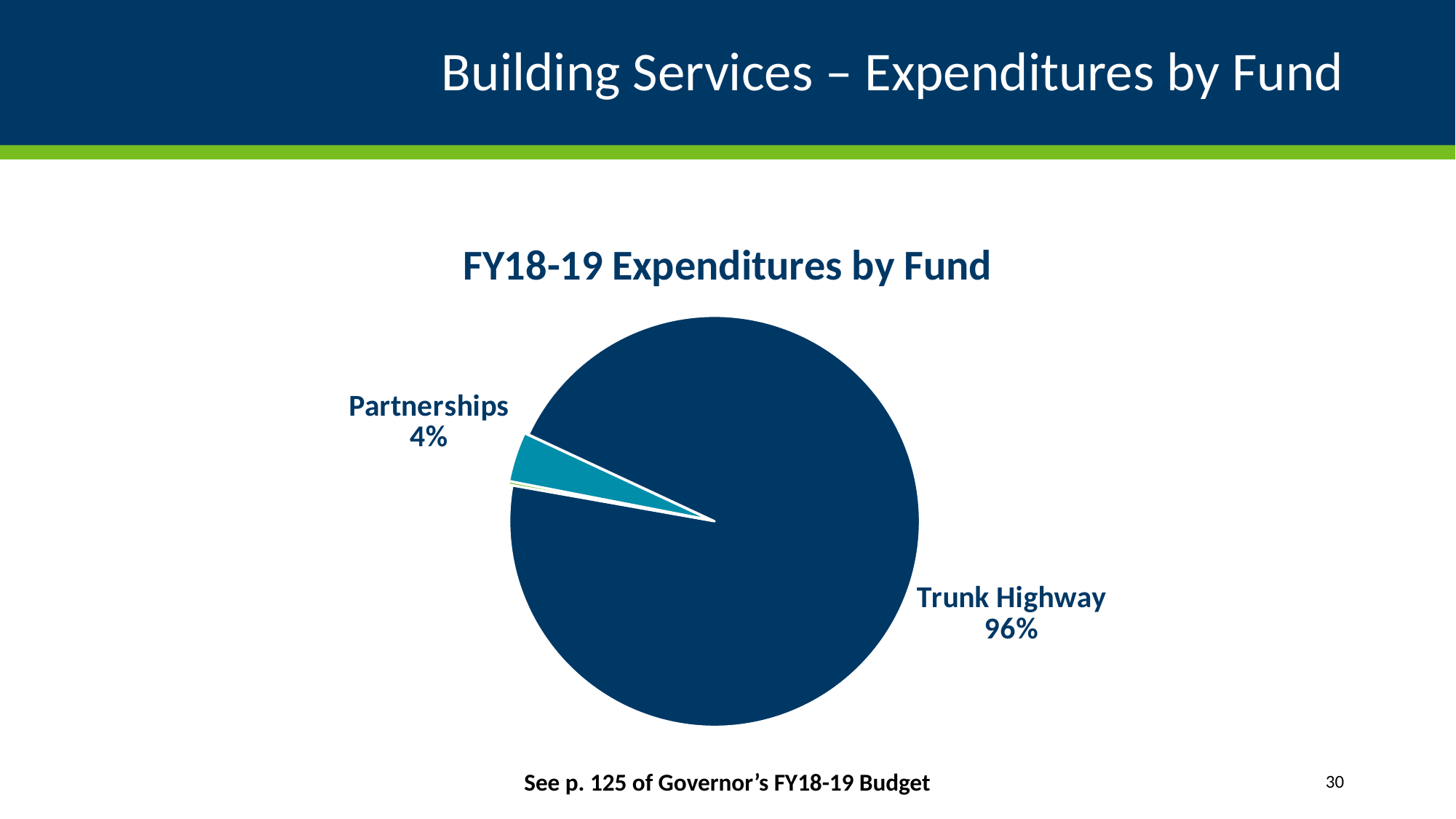
Which labeled fund has the smallest share of expenditures? Partnerships What is the title of the chart? FY18-19 Expenditures by Fund What is the difference in percentage points between the Trunk Highway share and the Partnerships share? 92 percentage points How many labeled slices does the pie chart have? 2 What kind of chart is shown on the slide? Pie chart What colour is the Partnerships slice? Teal Which fund has the largest share of expenditures? Trunk Highway What share of expenditures comes from Partnerships? 4% What is the combined share of the Trunk Highway and Partnerships slices? 100% Which is larger, the Partnerships share or the Trunk Highway share? Trunk Highway What share of expenditures comes from the Trunk Highway fund? 96%